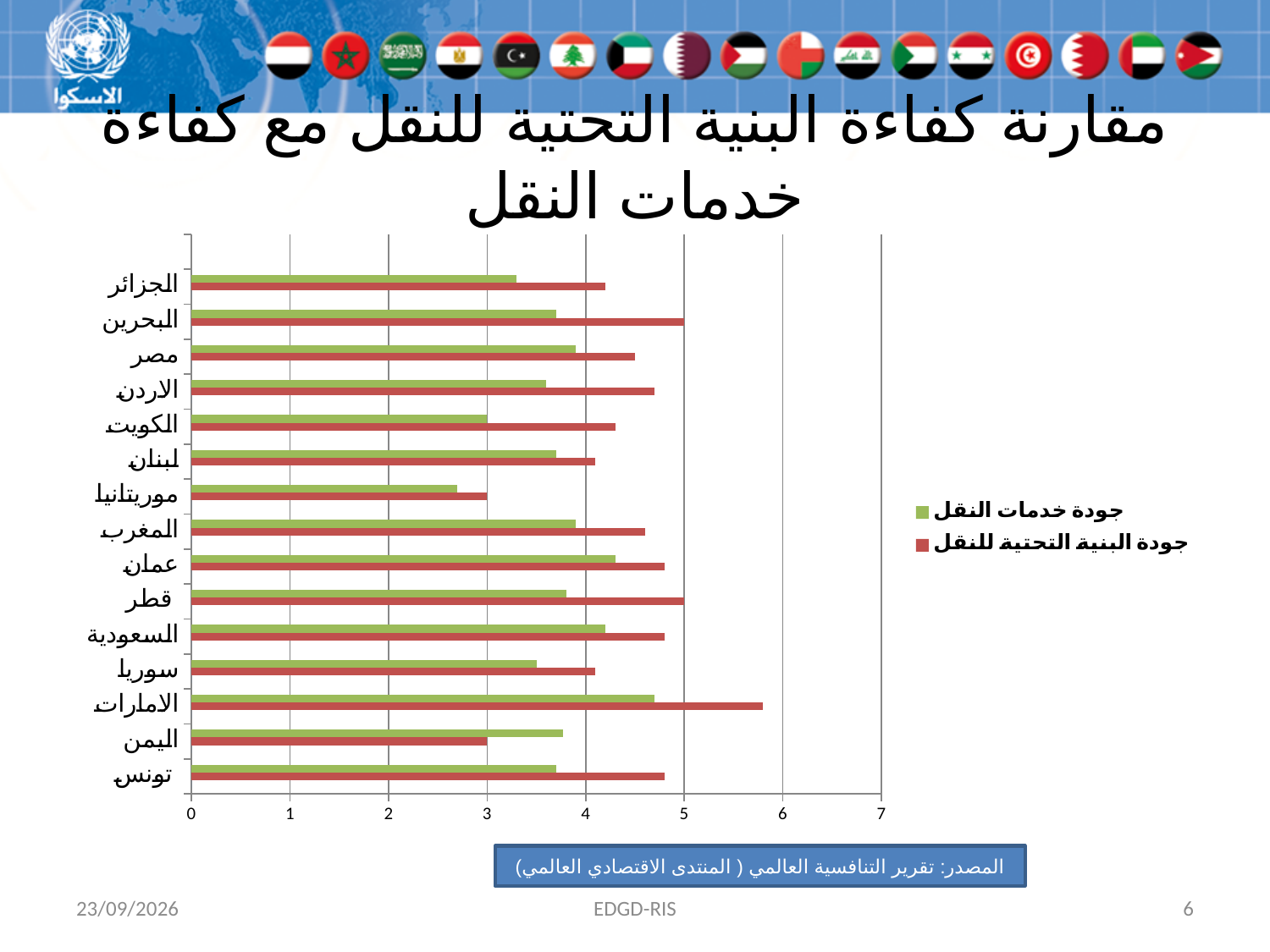
What kind of chart is shown on the slide? Bar chart How many countries are listed on the vertical axis of the chart? 15 Which colour represents جودة البنية التحتية للنقل in the chart? Red Which country has the highest value for جودة البنية التحتية للنقل? الامارات For اليمن, which series has the larger value: جودة خدمات النقل or جودة البنية التحتية للنقل? جودة خدمات النقل Which country has the highest value for جودة خدمات النقل? الامارات Is the value of جودة خدمات النقل for الجزائر greater or less than 4? less How many series does the chart's legend list? 2 Is the value of جودة خدمات النقل for موريتانيا greater or less than 3? less Which has the larger value for جودة البنية التحتية للنقل: الامارات or الجزائر? الامارات Is the value of جودة البنية التحتية للنقل for الامارات greater or less than 5? greater Which country has the lowest value for جودة خدمات النقل? موريتانيا